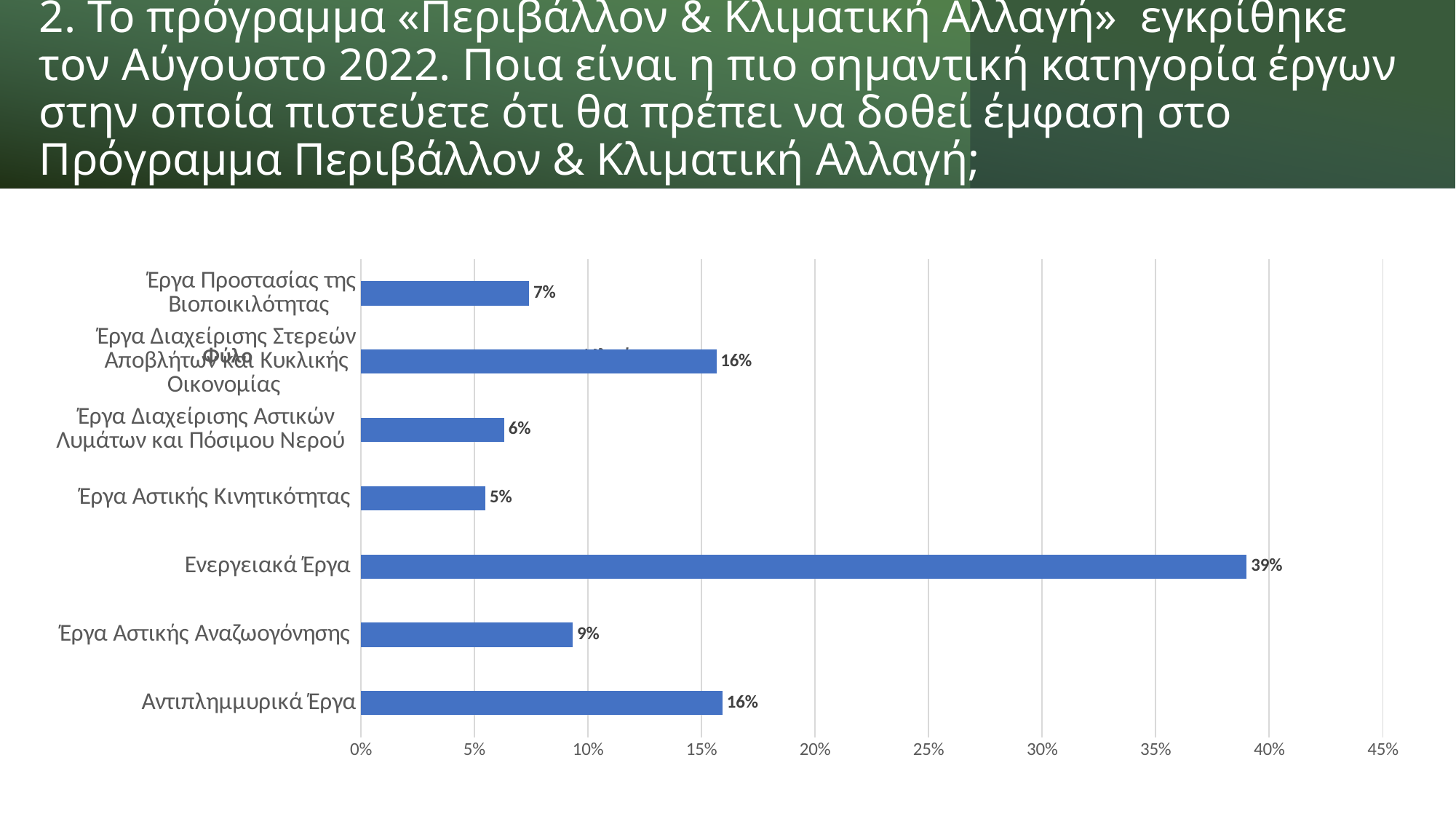
Which category has the highest value? Ενεργειακά Έργα What is the difference between the values for Έργα Προστασίας της Βιοποικιλότητας and Έργα Αστικής Κινητικότητας? 2% How many categories are shown in the chart? 7 What is the value for Έργα Προστασίας της Βιοποικιλότητας? 7% Which category has the lowest value? Έργα Αστικής Κινητικότητας What is the value for Ενεργειακά Έργα? 39% Is the value for Ενεργειακά Έργα greater or less than 35%? greater Which is larger, the value for Έργα Αστικής Αναζωογόνησης or the value for Έργα Διαχείρισης Αστικών Λυμάτων και Πόσιμου Νερού? Έργα Αστικής Αναζωογόνησης What is the value for Έργα Αστικής Αναζωογόνησης? 9% What kind of chart is shown on the slide? bar chart What is the value for Αντιπλημμυρικά Έργα? 16% What is the difference between the values for Ενεργειακά Έργα and Αντιπλημμυρικά Έργα? 23%